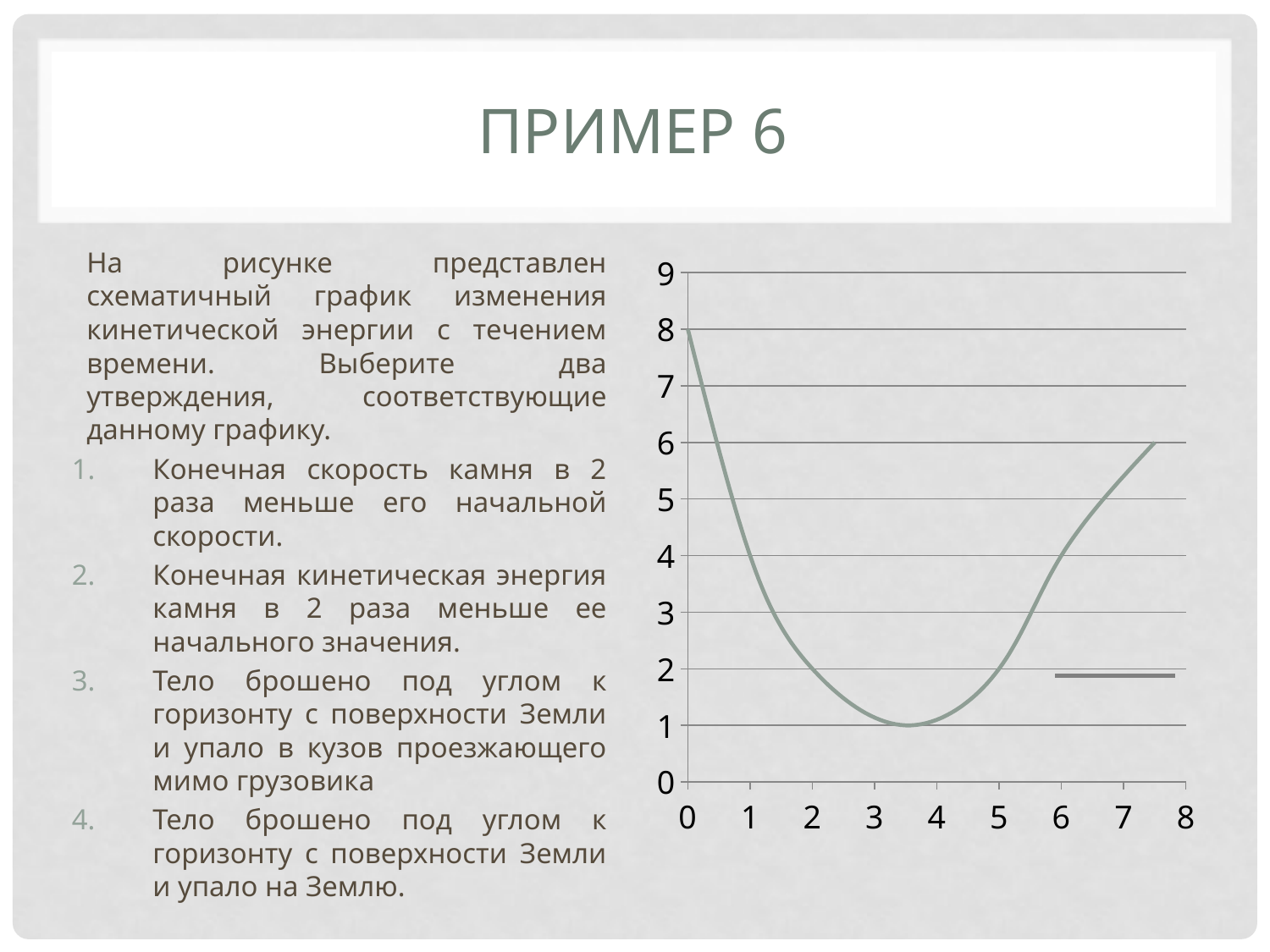
How does the curve behave along the x axis? falls, then rises What kind of chart is shown on the slide? line chart Is the value of the curve at x = 7 greater or less than 6? less Is the value of the curve at x = 5 greater or less than 3? less Which is larger: the value of the curve at its start (x = 0) or at its end? at the start (x = 0) What is the highest tick label on the x axis? 8 What is the lowest value the curve reaches? 1 What is the highest value the curve reaches? 8 What is the highest tick label on the y axis? 9 What is the value of the curve at x = 0? 8 Is the value of the curve at x = 1 greater or less than 3? greater